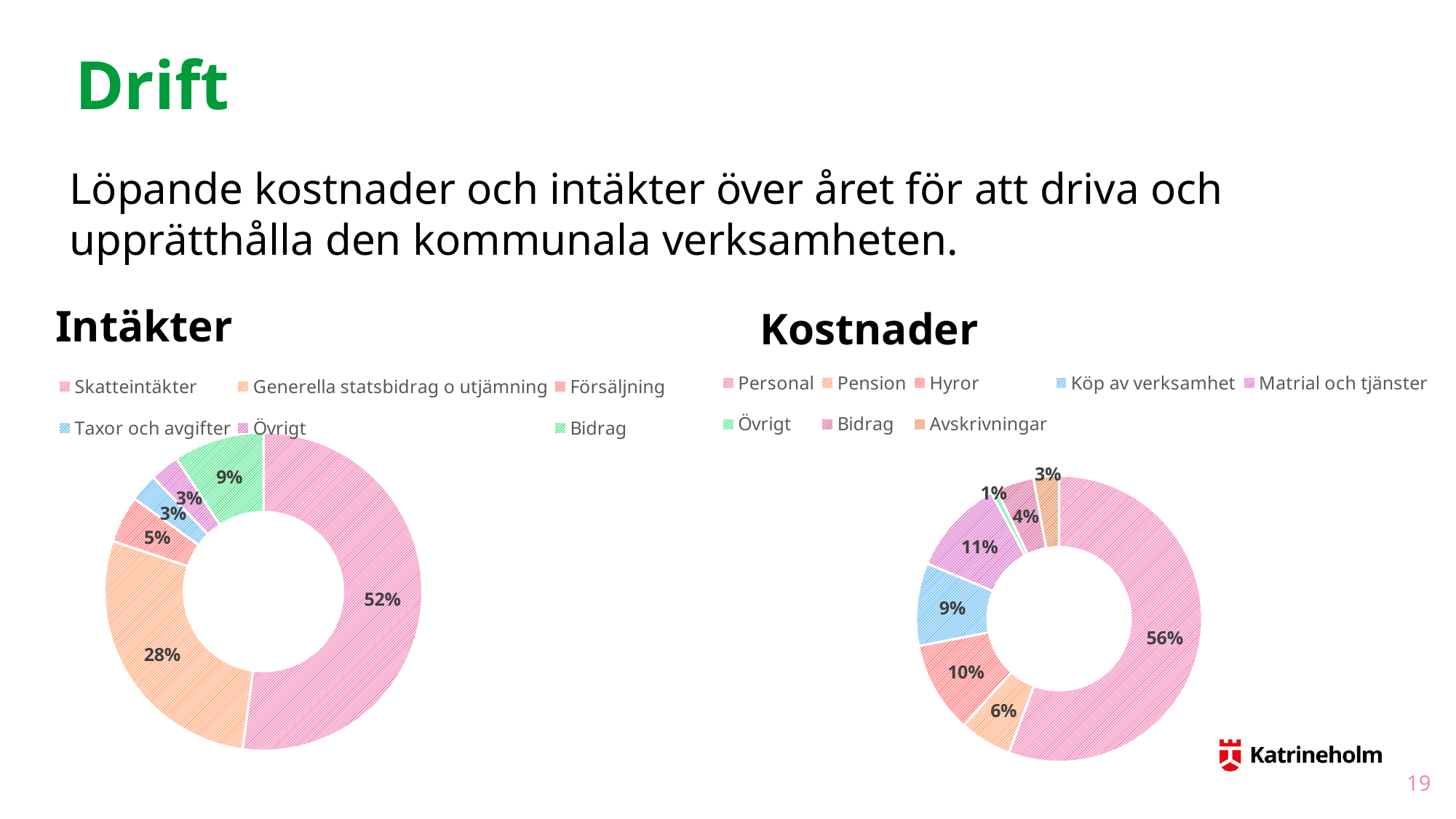
In the Intäkter chart, which category has the largest share? Skatteintäkter In the Kostnader chart, how many categories does the legend list? 8 In the Kostnader chart, which is larger, Hyror or Köp av verksamhet? Hyror In the Kostnader chart, what share is Matrial och tjänster? 11% What type of chart is used for Kostnader? Donut (pie) chart In the Kostnader chart, which category has the smallest share? Övrigt In the Intäkter chart, what share is Bidrag? 9% In the Kostnader chart, what share is Personal? 56% In the Intäkter chart, how many categories does the legend list? 6 In the Intäkter chart, what share is Skatteintäkter? 52% In the Intäkter chart, what share is Generella statsbidrag o utjämning? 28% In the Intäkter chart, what is the difference between the shares of Skatteintäkter and Generella statsbidrag o utjämning? 24 percentage points